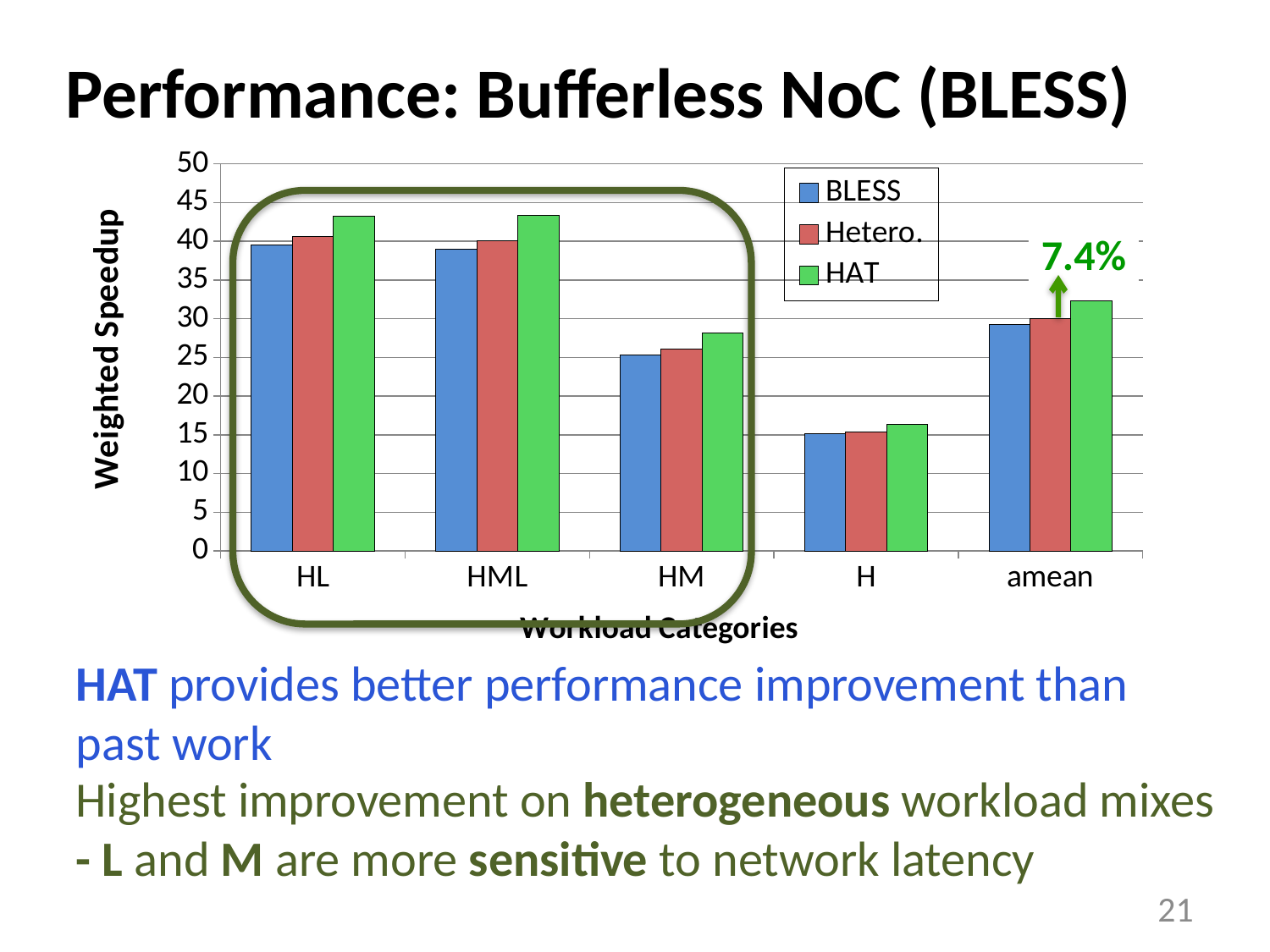
Which workload category has the lowest weighted speedup for HAT? H How many workload categories are shown on the x axis? 5 What is the label of the y axis? Weighted Speedup For the HM category, which is larger: the BLESS value or the HAT value? HAT What percentage improvement is annotated above the amean bars? 7.4% Is the HAT value for HL greater or less than 40? greater Is the HAT value for amean greater or less than 30? greater How many series does the legend list? 3 Which workload category has the lowest weighted speedup for BLESS? H What kind of chart is shown on the slide? bar chart Is the Hetero. value for H greater or less than 20? less